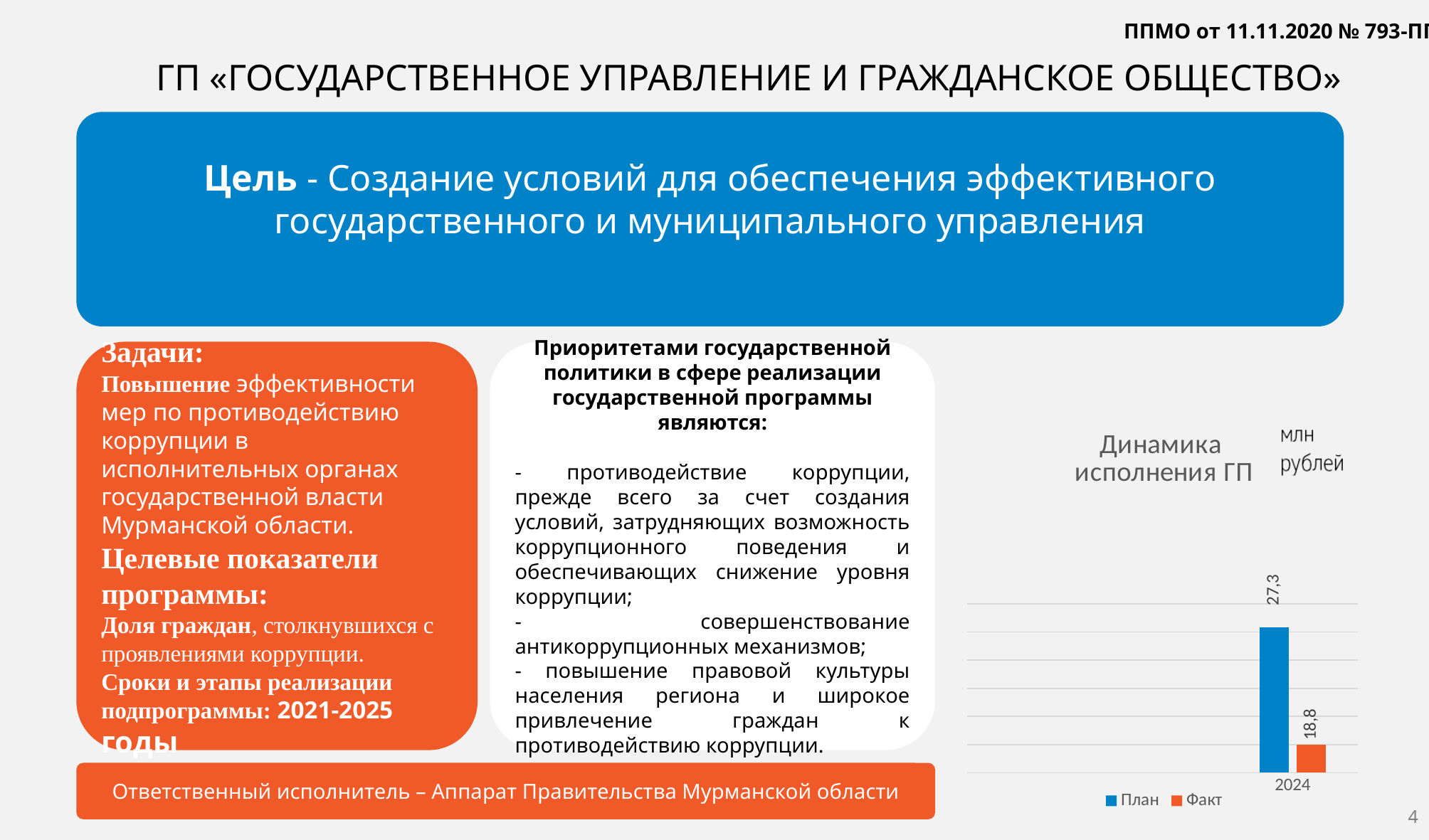
What unit is indicated for the values in the chart "Динамика исполнения ГП"? млн рублей Which series has the lowest value in the chart "Динамика исполнения ГП"? Факт How many series does the legend of the chart "Динамика исполнения ГП" list? 2 What is the value of Факт for 2024 in the chart "Динамика исполнения ГП"? 18,8 What is the difference between План and Факт for 2024 in the chart "Динамика исполнения ГП"? 8,5 How many categories are shown on the x axis of the chart "Динамика исполнения ГП"? 1 What year is shown on the x axis of the chart "Динамика исполнения ГП"? 2024 What is the value of План for 2024 in the chart "Динамика исполнения ГП"? 27,3 What kind of chart is "Динамика исполнения ГП"? bar chart Which series has the higher value for 2024 in the chart "Динамика исполнения ГП", План or Факт? План